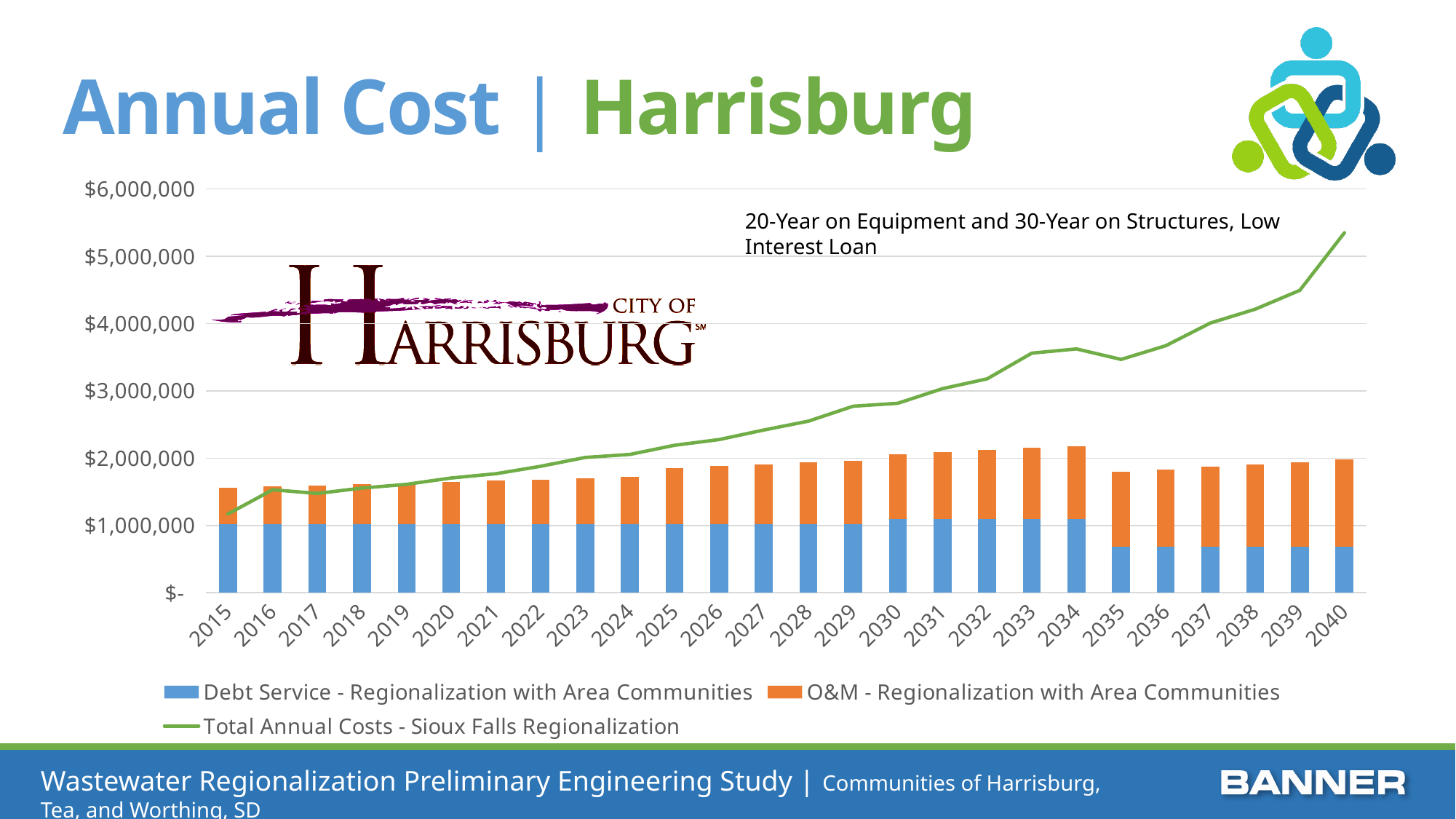
What kind of chart is shown on the slide? Combined stacked bar and line chart Is the value for Debt Service - Regionalization with Area Communities in 2035 greater or less than $1,000,000? less Which series is shown in orange in the chart legend? O&M - Regionalization with Area Communities Is the value for Total Annual Costs - Sioux Falls Regionalization in 2015 greater or less than $2,000,000? less In 2040, which is larger: the Total Annual Costs - Sioux Falls Regionalization line or the total of the stacked bar? Total Annual Costs - Sioux Falls Regionalization line In which year is the Total Annual Costs - Sioux Falls Regionalization line at its highest? 2040 Is the total height of the stacked bar for 2034 greater or less than $2,000,000? greater Does the Total Annual Costs - Sioux Falls Regionalization line generally rise or fall from 2015 to 2040? Rise How many years are shown on the x axis of the chart? 26 How many series does the chart legend list? 3 In which year is the Total Annual Costs - Sioux Falls Regionalization line at its lowest? 2015